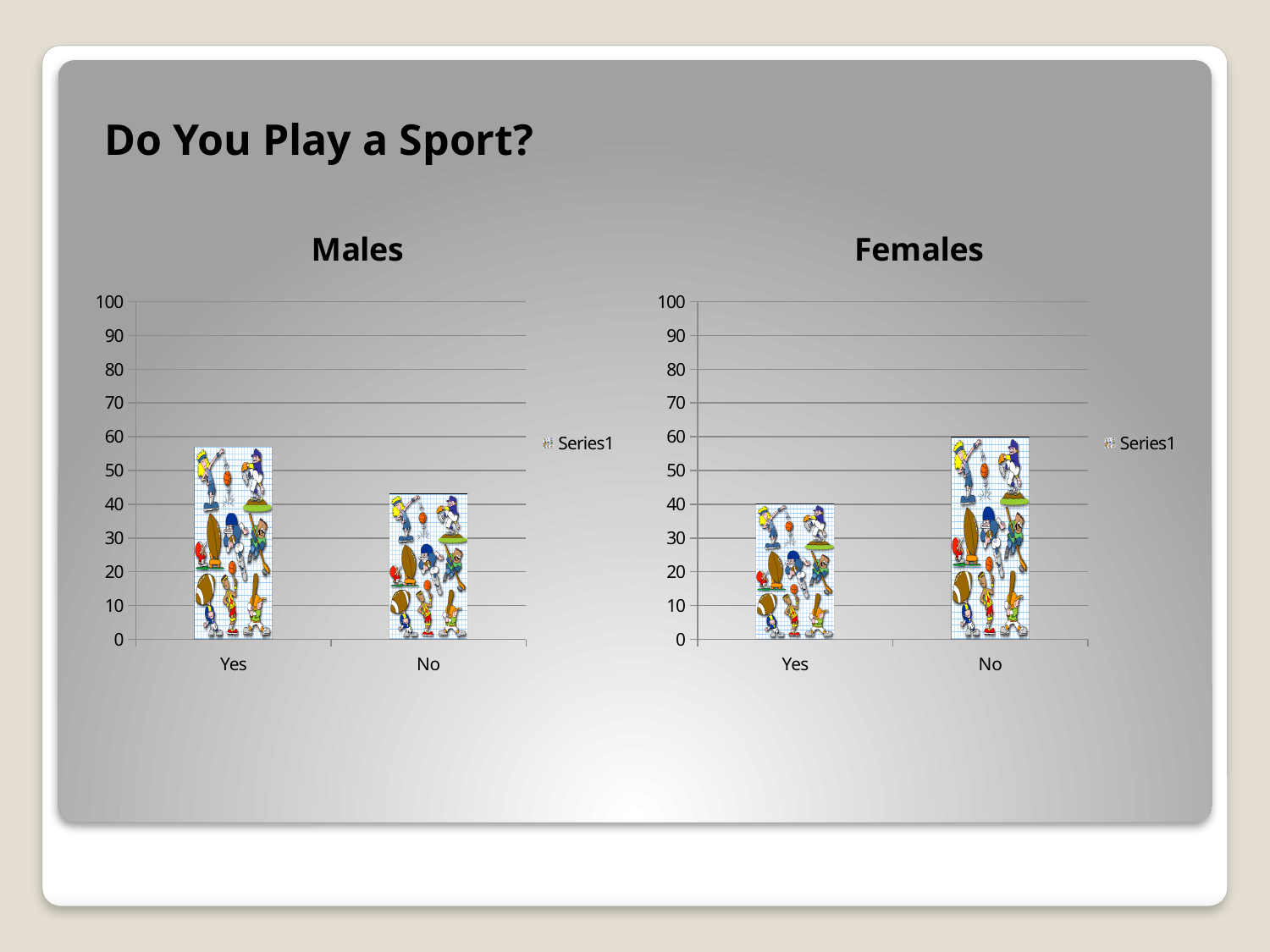
In the Females chart, which category has the higher value, Yes or No? No In the Females chart, how many series does the legend list? 1 In the Females chart, which category has the lowest value? Yes In the Males chart, how many categories are shown on the x axis? 2 In the Males chart, is the value for No greater or less than 50? less In the Males chart, which category has the higher value, Yes or No? Yes In the Females chart, what is the value for Yes? 40 In the Males chart, is the value for Yes greater or less than 50? greater What is the legend entry shown in the Males chart? Series1 In the Females chart, what is the value for No? 60 What type of chart is the Males chart? bar chart In the Females chart, what is the difference between the values for No and Yes? 20